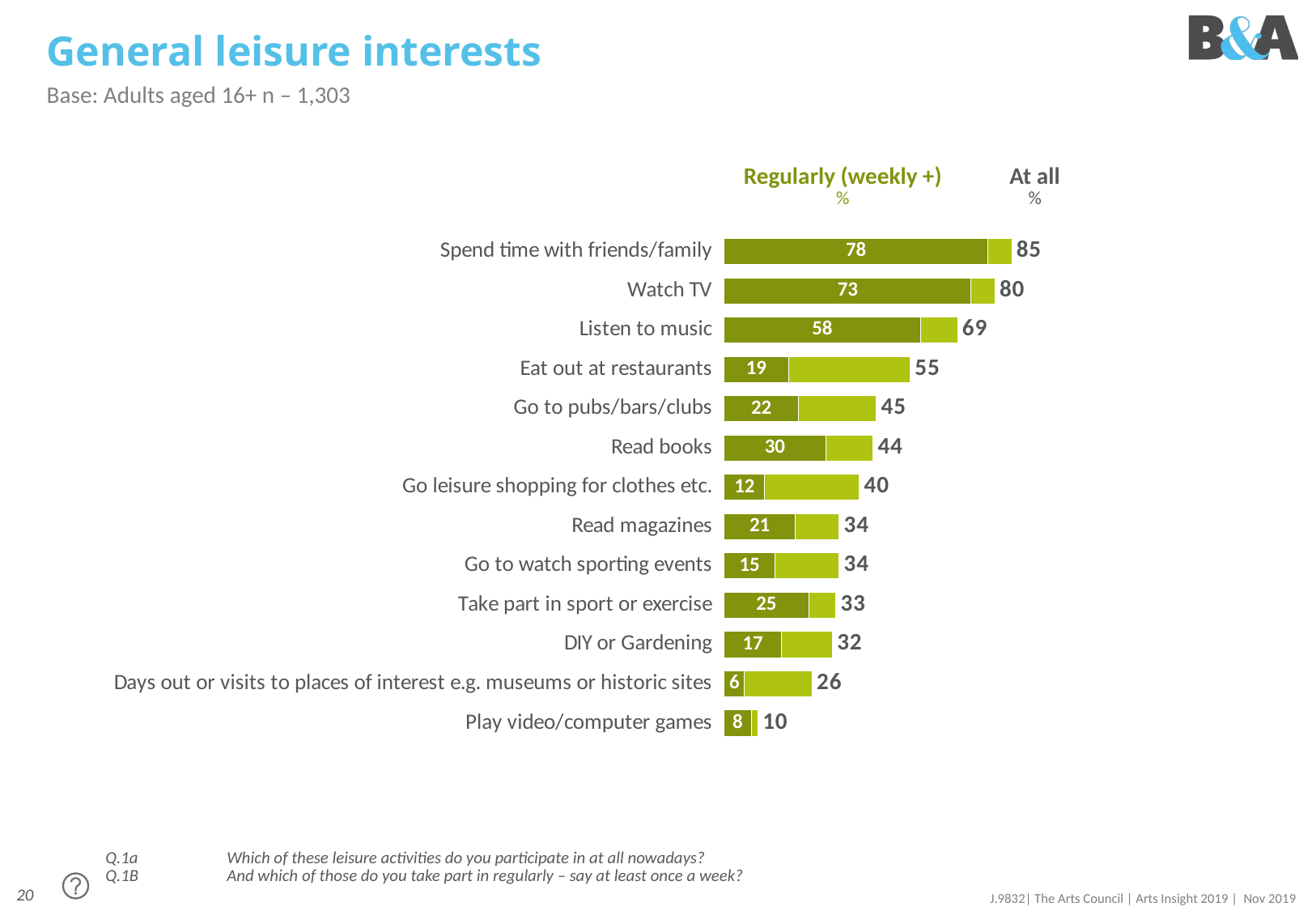
What is the difference between the 'At all' values for Listen to music and Go to pubs/bars/clubs? 24 Which is larger: the 'Regularly (weekly +)' value for Read books or for Take part in sport or exercise? Read books Which activity has the highest 'At all' value? Spend time with friends/family What is the 'At all' value for Read books? 44 What is the 'Regularly (weekly +)' value for Days out or visits to places of interest e.g. museums or historic sites? 6 What is the 'Regularly (weekly +)' value for Watch TV? 73 What kind of chart is shown on the slide? Bar chart How many leisure activities are listed in the chart? 13 What is the base stated for the chart? Adults aged 16+ n – 1,303 Which activity has the lowest 'At all' value? Play video/computer games What is the difference between the 'At all' and 'Regularly (weekly +)' values for Eat out at restaurants? 36 How many series does the chart show? 2